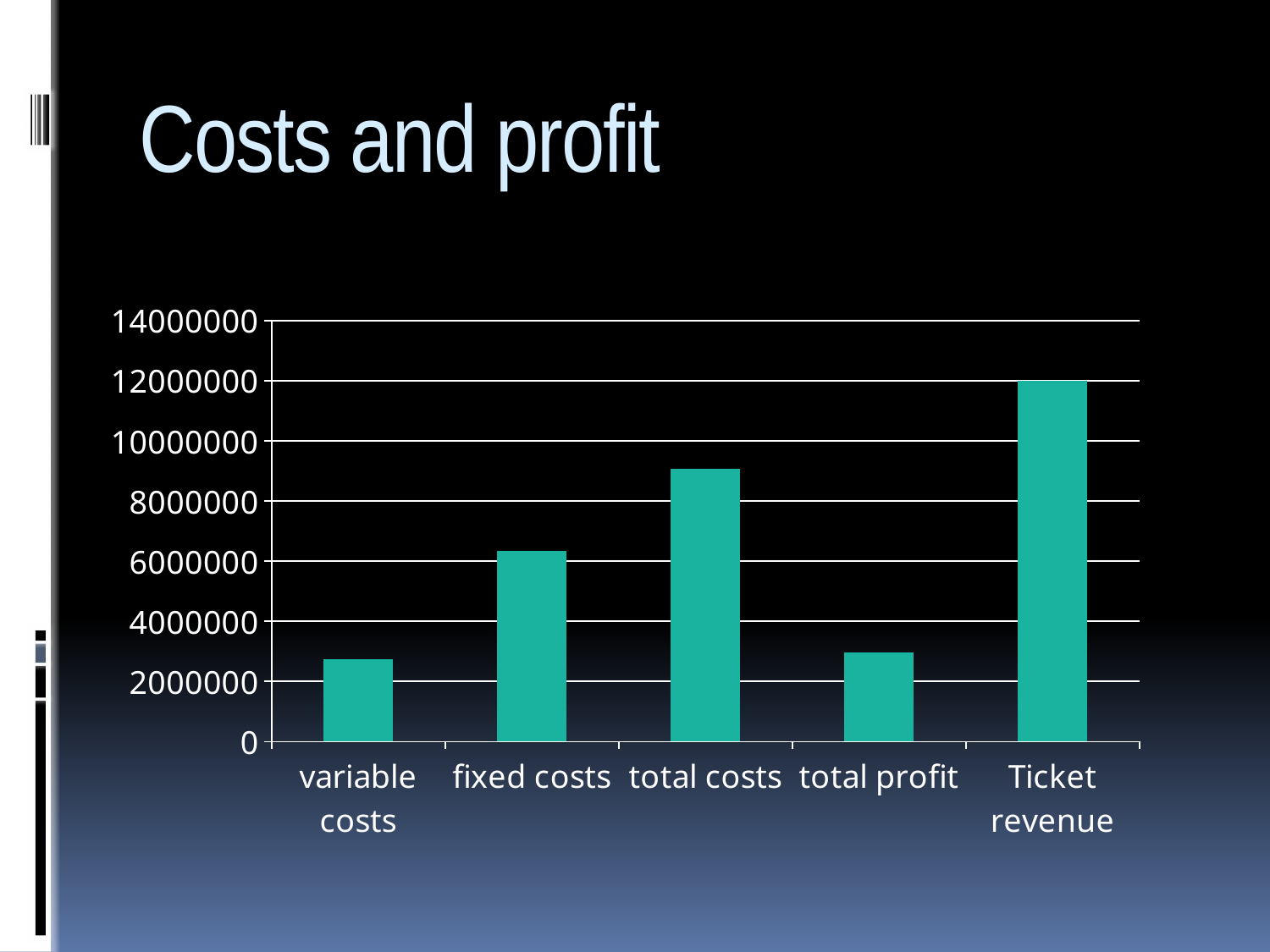
Which category has the highest value? Ticket revenue Which is larger, fixed costs or total costs? total costs What is the value for Ticket revenue? 12000000 Is the value for fixed costs greater or less than 6000000? greater What is the title of the slide? Costs and profit Which is larger, variable costs or fixed costs? fixed costs Is the value for variable costs greater or less than 4000000? less What is the highest value shown on the vertical axis? 14000000 What kind of chart is shown on the slide? bar chart How many categories are plotted on the chart? 5 Is the value for total costs greater or less than 8000000? greater